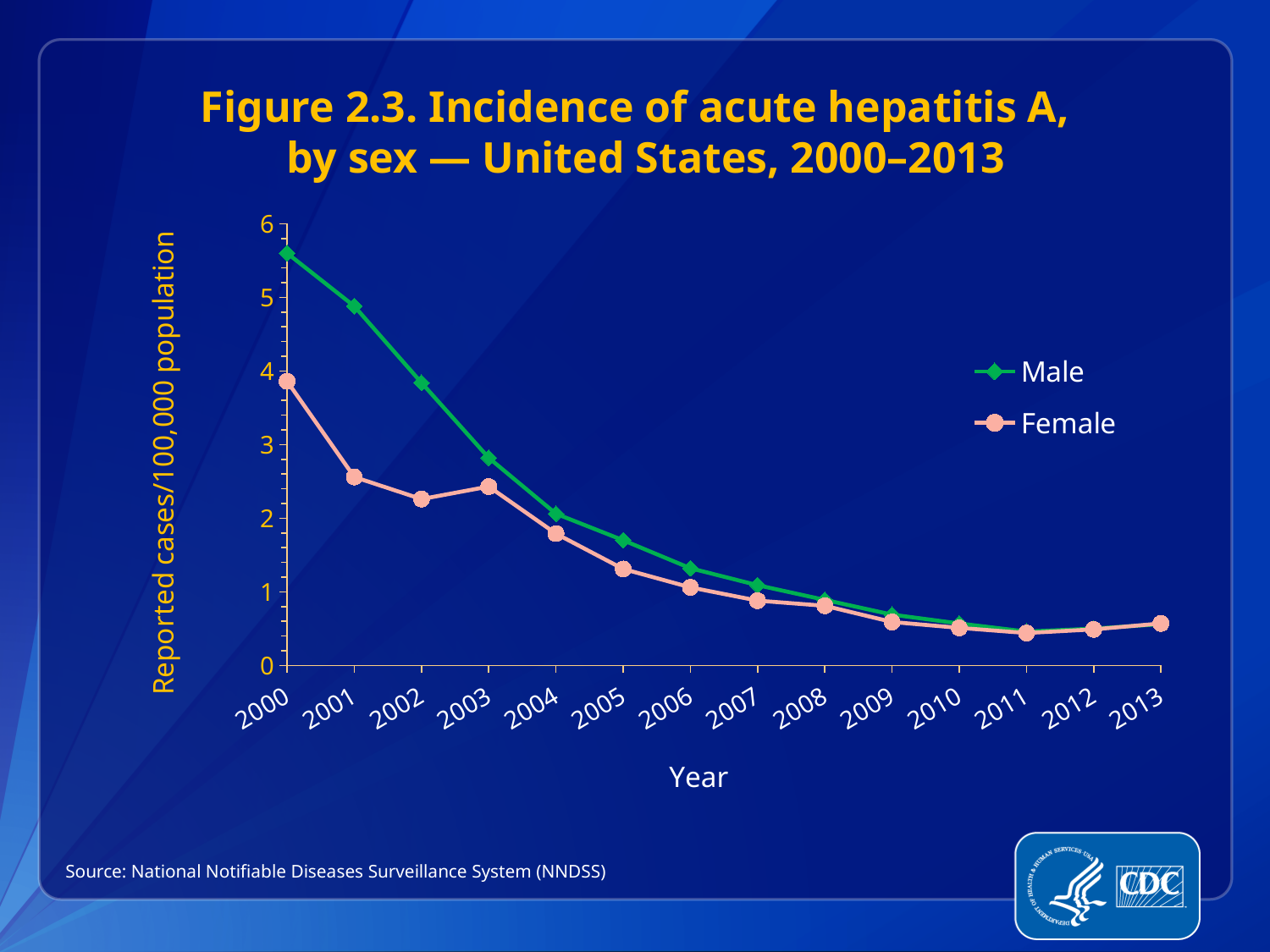
Is the Male value for 2010 greater or less than 1? less Is the Male value for 2000 greater or less than 5? greater In which year is the Female incidence rate highest? 2000 Is the Female value for 2001 greater or less than 2? greater What is the label of the y axis? Reported cases/100,000 population In which year is the Male incidence rate highest? 2000 What kind of chart is shown on the slide? line chart Overall, does the Male incidence rate rise or fall from 2000 to 2013? fall How many series does the legend list? 2 How many years are plotted along the x axis? 14 In 2002, which series has the higher value, Male or Female? Male